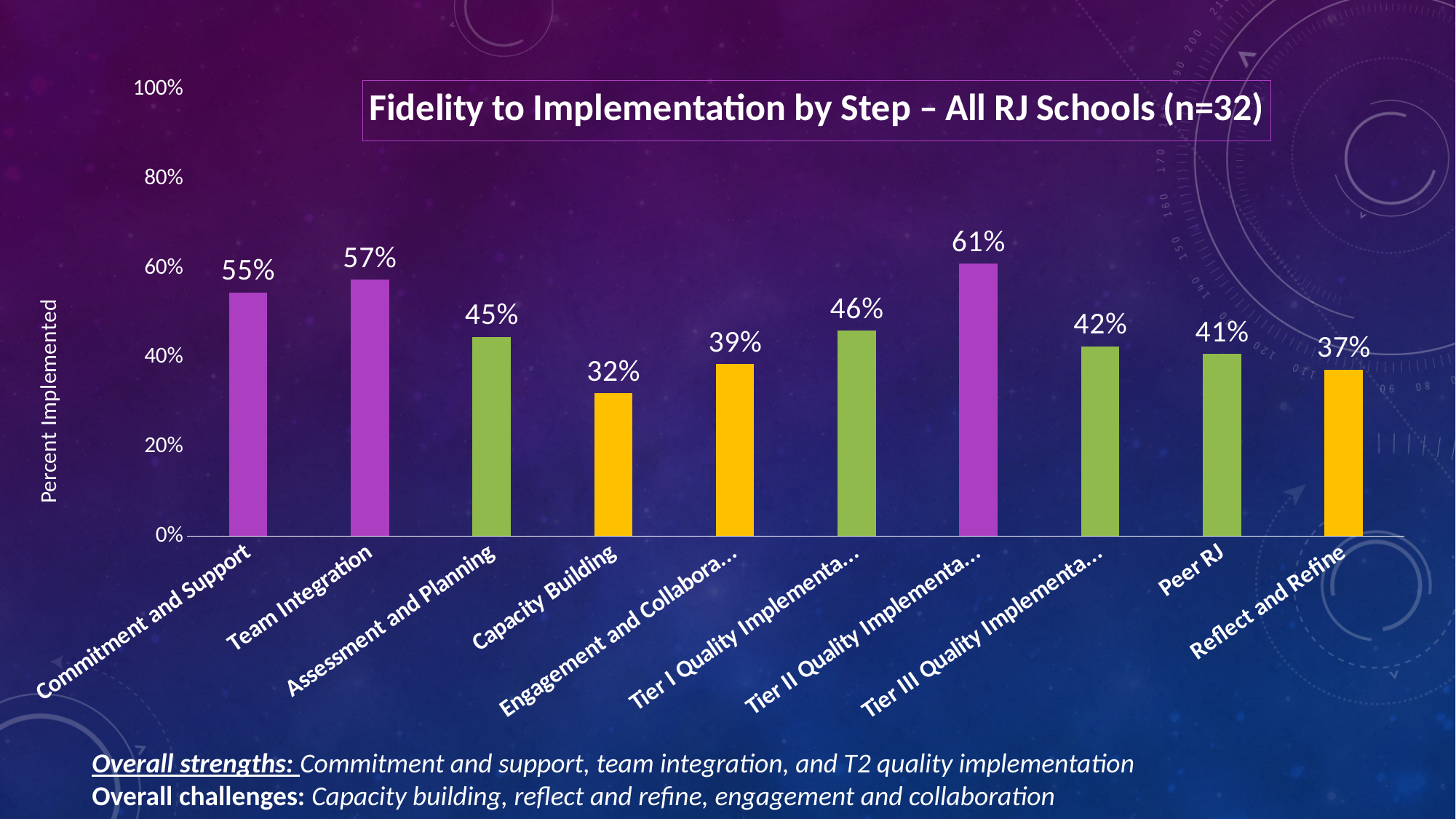
What is the value for Capacity Building? 32% What is the difference between the values for Team Integration and Commitment and Support? 2% How many steps (bars) are shown in the chart? 10 What kind of chart is shown on the slide? Bar chart What is the value for Team Integration? 57% What is the value for Reflect and Refine? 37% Is the value for Commitment and Support greater or less than 40%? greater Which is larger, the value for Assessment and Planning or the value for Peer RJ? Assessment and Planning Which step has the lowest percent implemented? Capacity Building What is the value for Peer RJ? 41% Which step has the highest percent implemented? Tier II Quality Implementation What is the title of the chart? Fidelity to Implementation by Step – All RJ Schools (n=32)